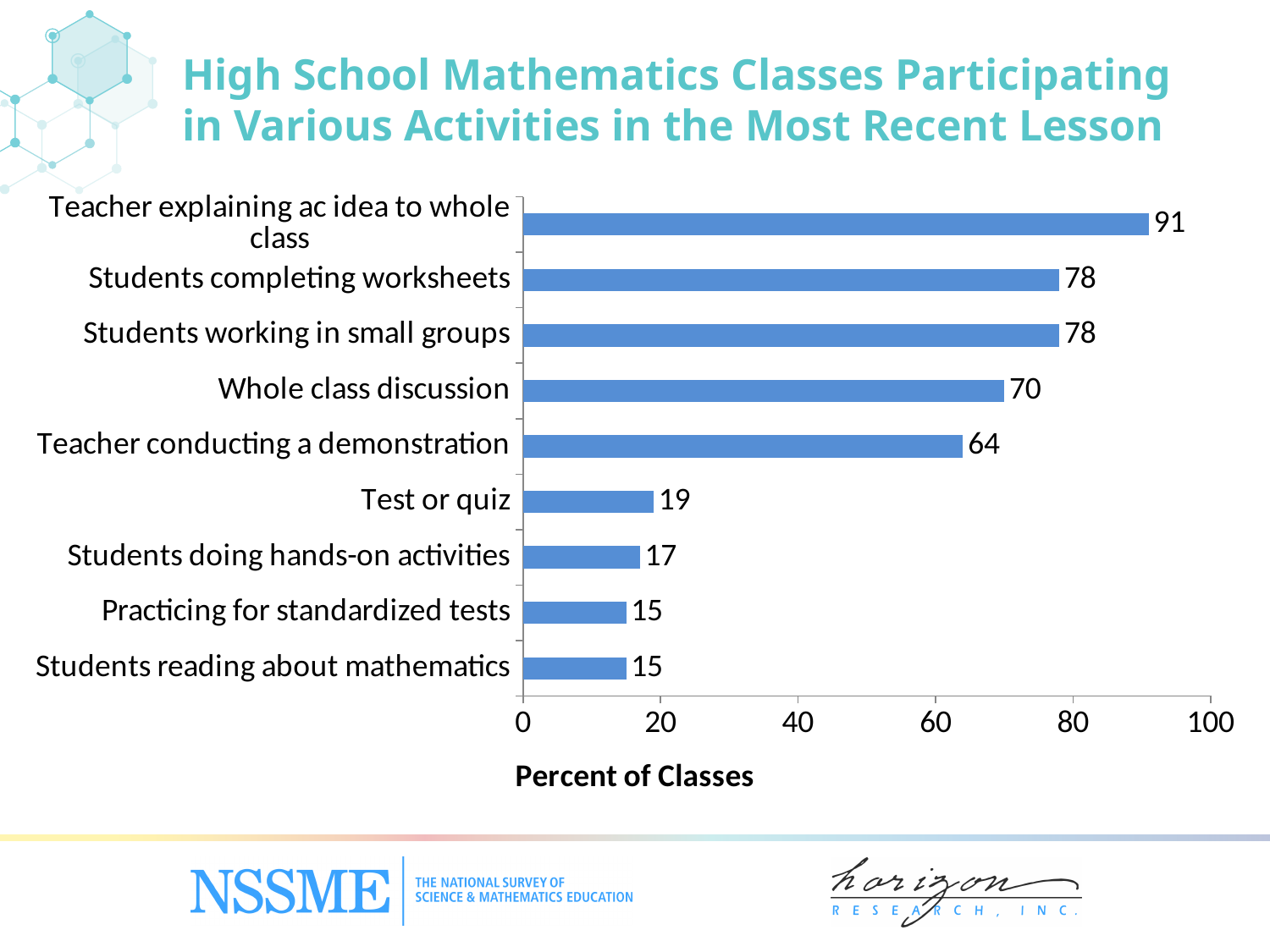
How many activities are shown in the chart? 9 What is the label of the horizontal axis? Percent of Classes What percent of classes had the teacher explaining an idea to the whole class? 91 What is the difference between Students completing worksheets and Whole class discussion? 8 What is the difference between Teacher explaining an idea to whole class and Students reading about mathematics? 76 Which is larger, Test or quiz or Students doing hands-on activities? Test or quiz Is the value for Teacher conducting a demonstration greater or less than 60? greater Which activity has the highest percent of classes? Teacher explaining ac idea to whole class What is the value for Teacher conducting a demonstration? 64 What kind of chart is shown on the slide? Bar chart What is the value for Whole class discussion? 70 What is the value for Test or quiz? 19